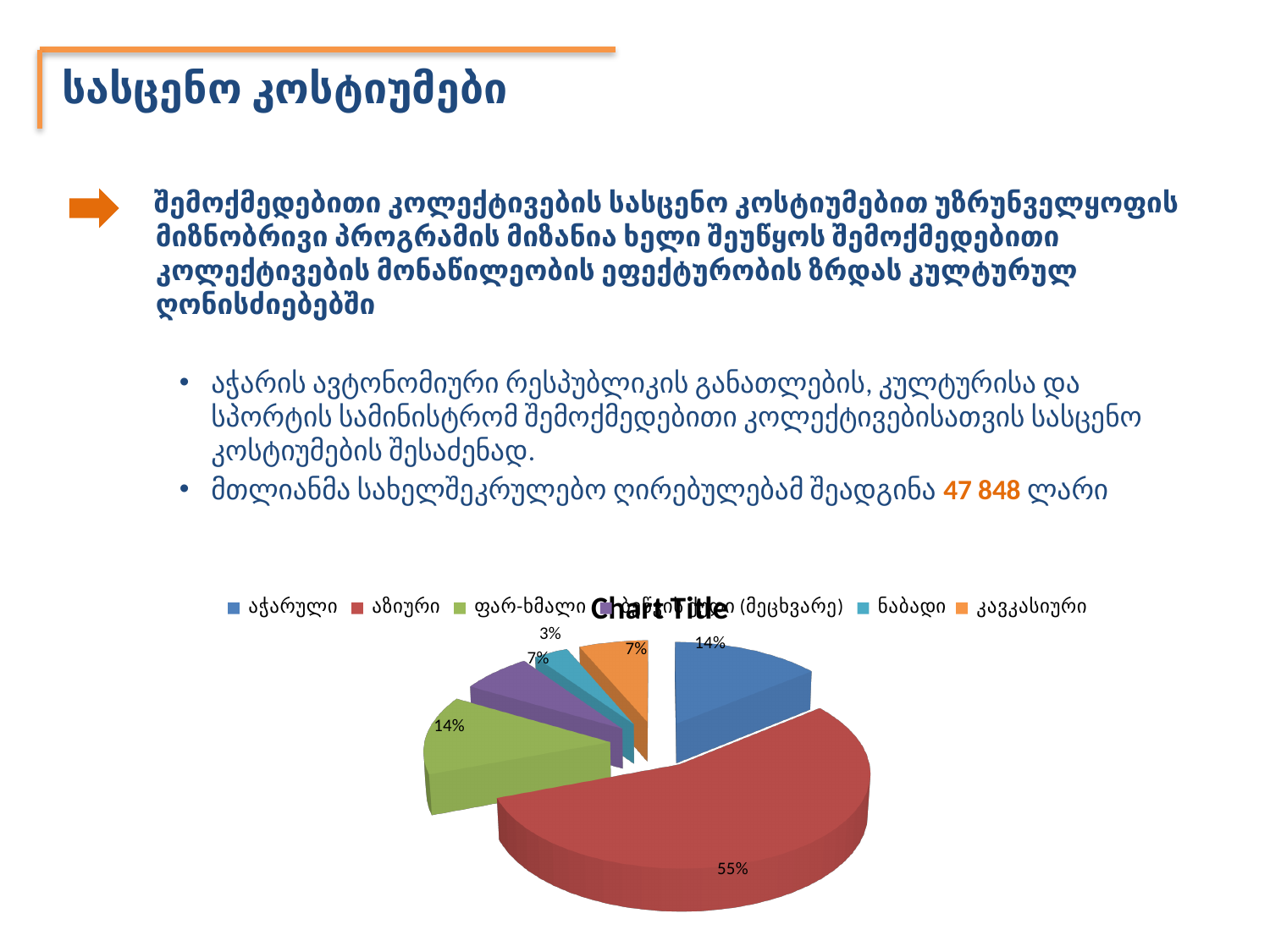
Which is larger, the slice for აზიური or the slice for ფარ-ხმალი? აზიური What percentage is shown for კავკასიური? 7% What percentage is shown for ნაბადი? 3% Which category has the largest slice of the pie? აზიური How many categories does the chart legend list? 6 Which category has the smallest slice of the pie? ნაბადი What percentage is shown for ფარ-ხმალი? 14% What percentage is shown for აჭარული? 14% How many percentage points larger is the აზიური slice than the აჭარული slice? 41% What percentage of the pie does აზიური account for? 55% What type of chart is shown on the slide? Pie chart Which is larger, the slice for კავკასიური or the slice for ნაბადი? კავკასიური